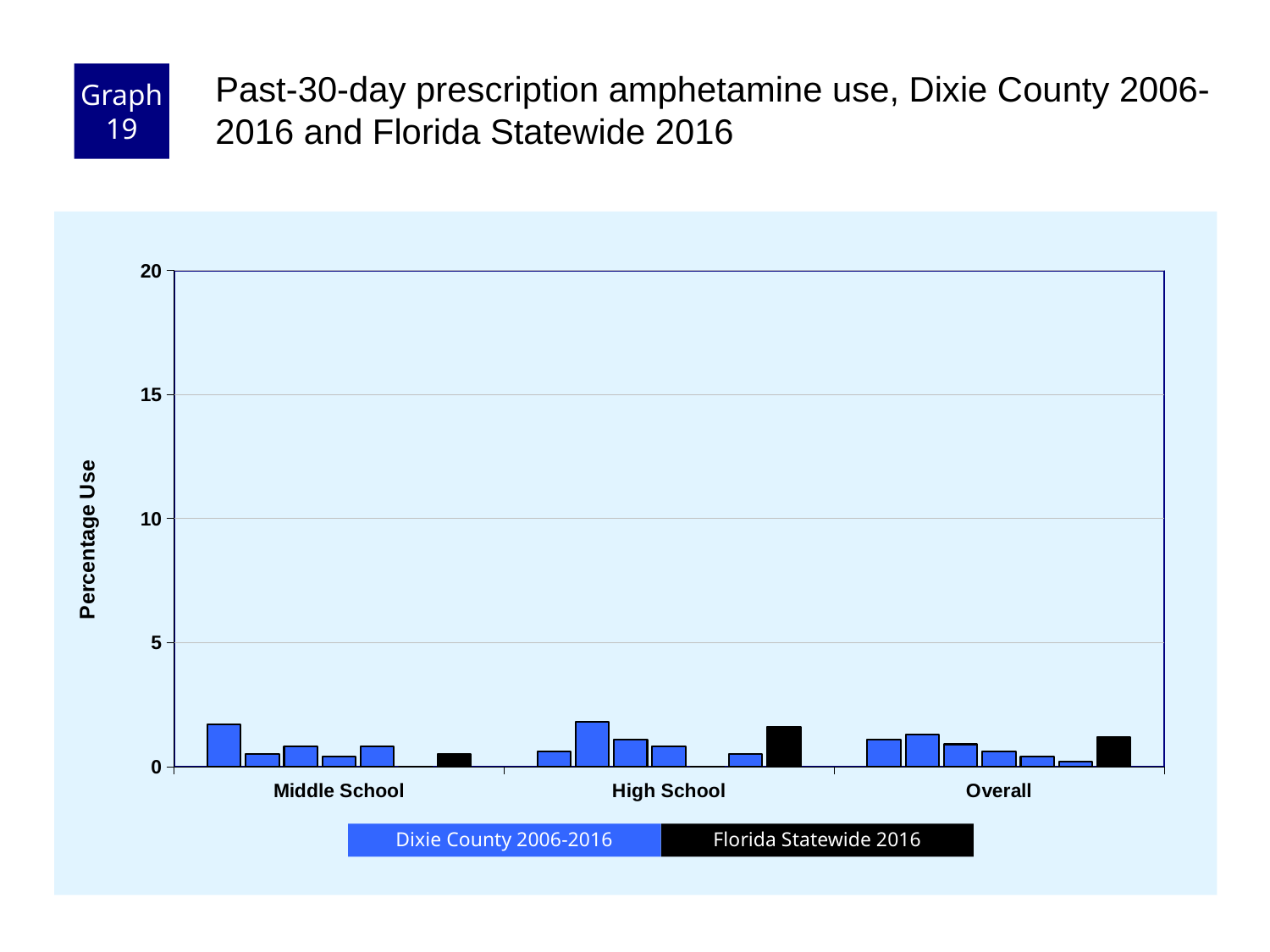
Is the Florida Statewide 2016 value for Overall greater or less than 10? less Is the Florida Statewide 2016 bar larger for High School or for Middle School? High School How many school-level categories are shown on the x axis? 3 Is the Florida Statewide 2016 bar larger for Overall or for Middle School? Overall Which category has the lowest Florida Statewide 2016 bar? Middle School Is the Florida Statewide 2016 value for High School greater or less than 5? less Is the Florida Statewide 2016 value for Middle School greater or less than 5? less What is the label on the y axis? Percentage Use Which colour represents Florida Statewide 2016 in the legend? black How many series does the legend list? 2 What kind of chart is shown on the slide? bar chart Which category has the highest Florida Statewide 2016 bar? High School